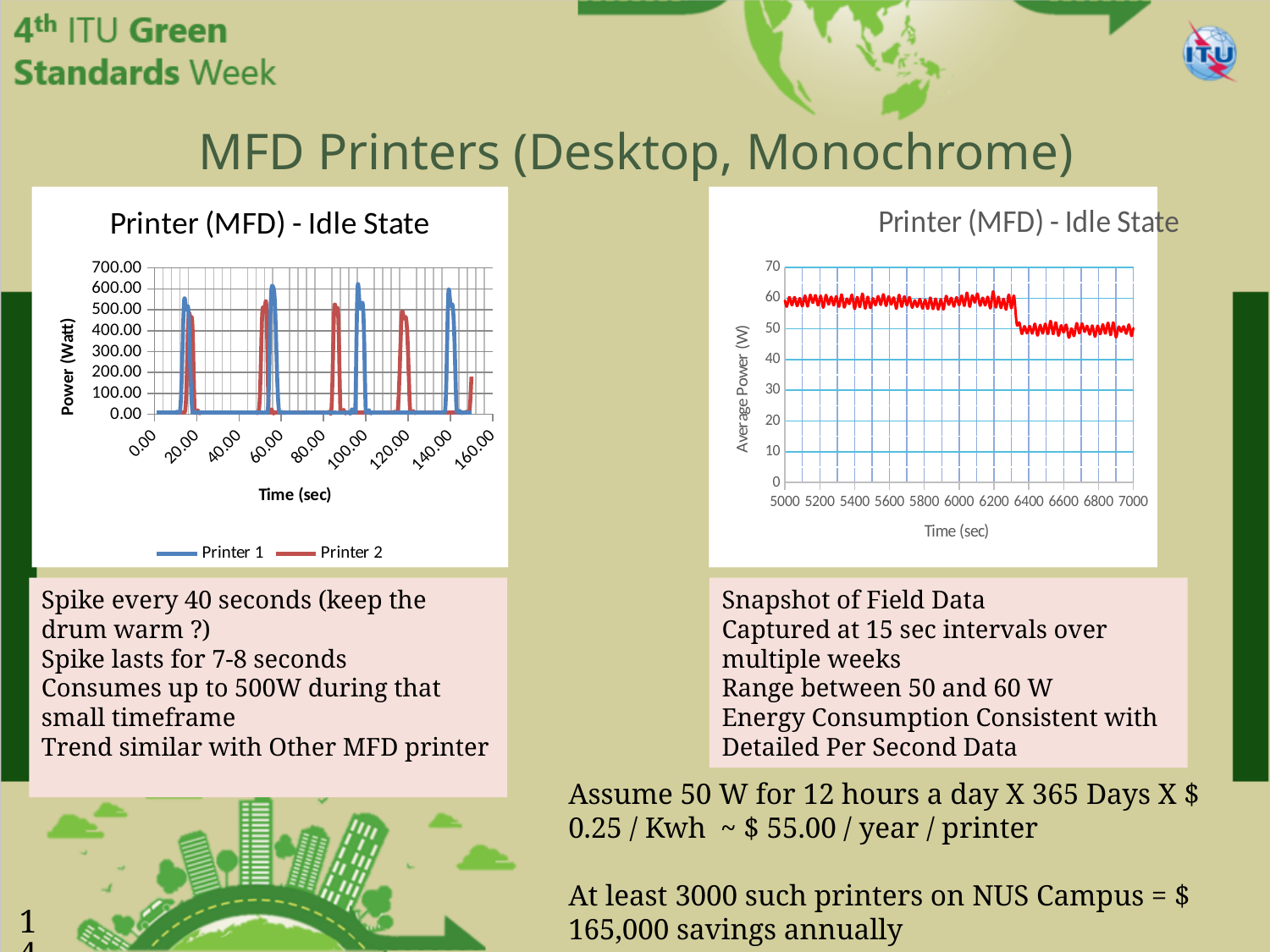
In the right chart, is the average power at time 6800 greater or less than 60? less How many series does the legend of the left chart list? 2 What are the two series named in the legend of the left chart? Printer 1 and Printer 2 In the left chart, between the spikes, is the power for Printer 1 greater or less than 100.00? less How many tick labels are shown on the x axis of the right chart? 11 In the right chart, does the average power rise or fall as time increases from 5000 to 7000? fall In the left chart, is the highest peak of Printer 1 greater or less than 500.00? greater What kind of chart is the left chart on the slide? line chart What kind of chart is the right chart on the slide? line chart In the right chart, is the average power at time 5400 higher or lower than at time 6600? higher What is the y-axis title of the left chart? Power (Watt)